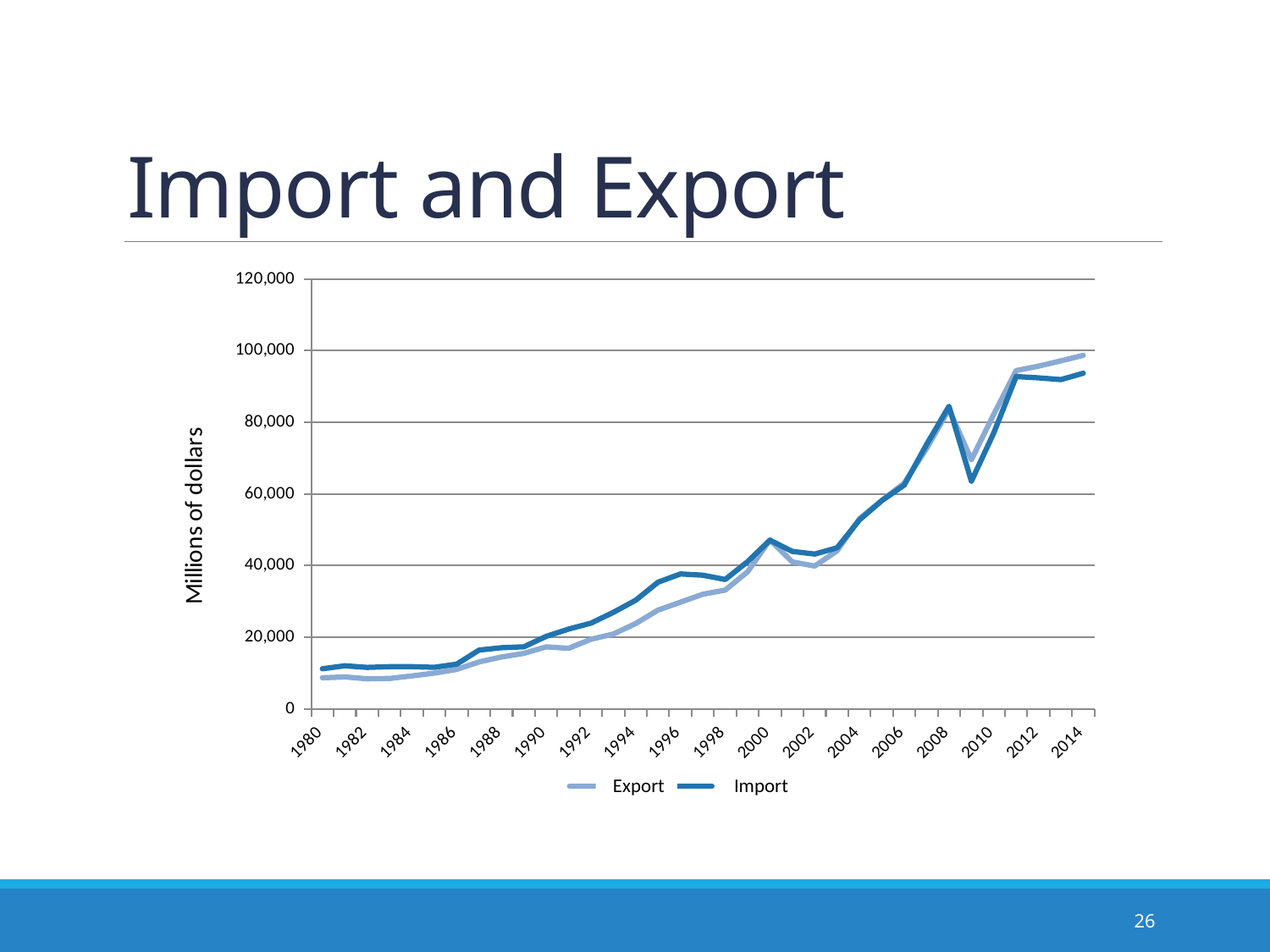
In which year is the Export value highest? 2014 How many series does the legend list? 2 Do the Export values generally rise or fall from 1980 to 2014? rise What is the label on the vertical axis? Millions of dollars What are the two series named in the legend? Export and Import Is the Export value for 1980 greater or less than 20,000? less Is the Import value for 1996 greater or less than 40,000? less In 2014, which is larger, Export or Import? Export Is the Import value for 2008 greater or less than 80,000? greater In 1996, which is larger, Export or Import? Import What kind of chart is shown on the slide? line chart